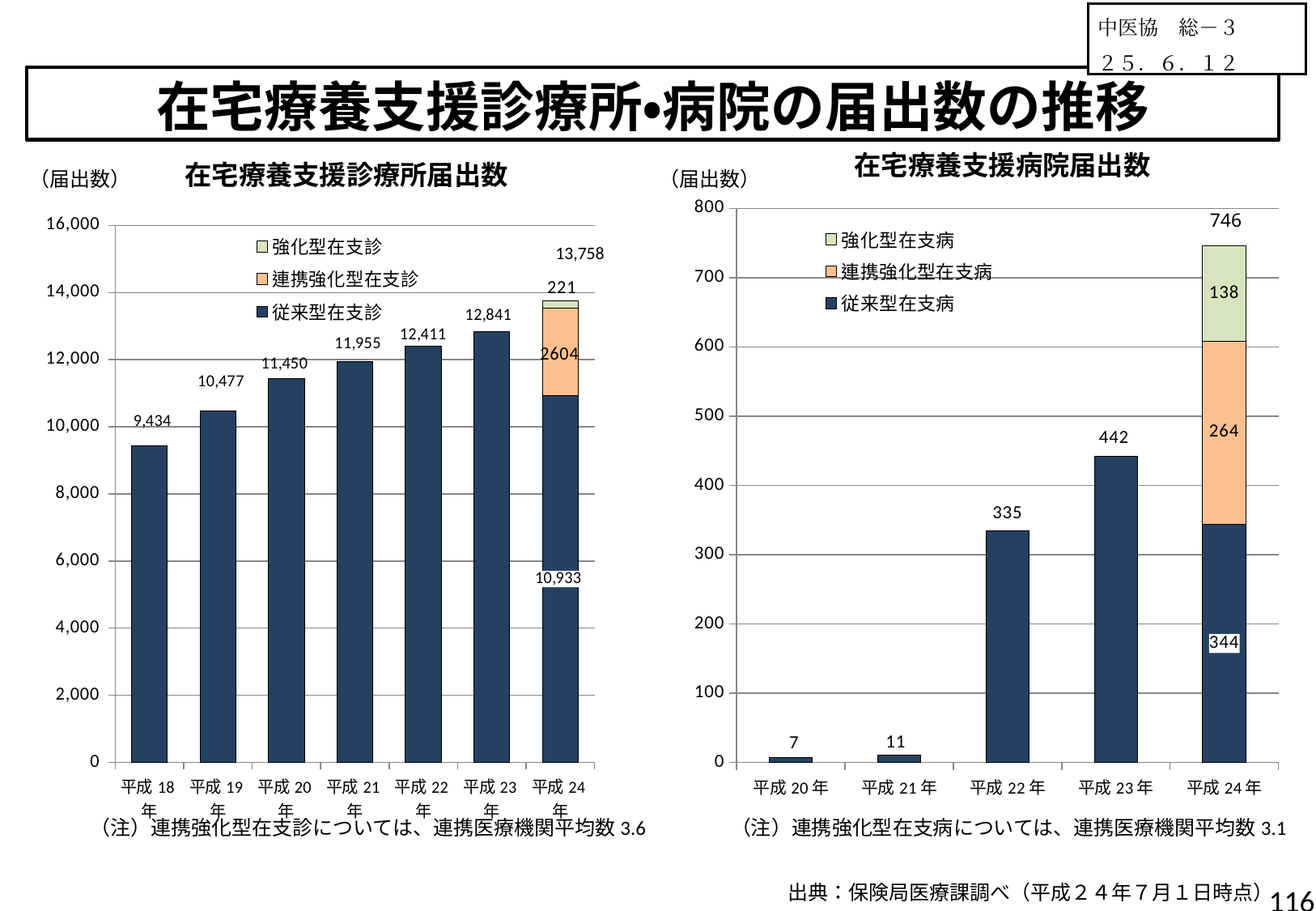
In the left chart (在宅療養支援診療所届出数), what is the total of the stacked bar for 平成24年? 13,758 In the left chart (在宅療養支援診療所届出数), what is the 連携強化型在支診 value for 平成24年? 2604 In the left chart (在宅療養支援診療所届出数), what is the value for 平成18年? 9,434 In the left chart (在宅療養支援診療所届出数), do the values rise or fall from 平成18年 to 平成24年? rise In the right chart (在宅療養支援病院届出数), what is the 強化型在支病 value for 平成24年? 138 In the right chart (在宅療養支援病院届出数), what is the value for 平成22年? 335 In the left chart (在宅療養支援診療所届出数), what is the difference between the values for 平成23年 and 平成22年? 430 What kind of chart is the right chart (在宅療養支援病院届出数)? bar chart In the right chart (在宅療養支援病院届出数), which year has the lowest value? 平成20年 In the left chart (在宅療養支援診療所届出数), how many series does the legend list? 3 In the right chart (在宅療養支援病院届出数), what is the difference between the values for 平成23年 and 平成22年? 107 In the left chart (在宅療養支援診療所届出数), what is the value for 平成22年? 12,411